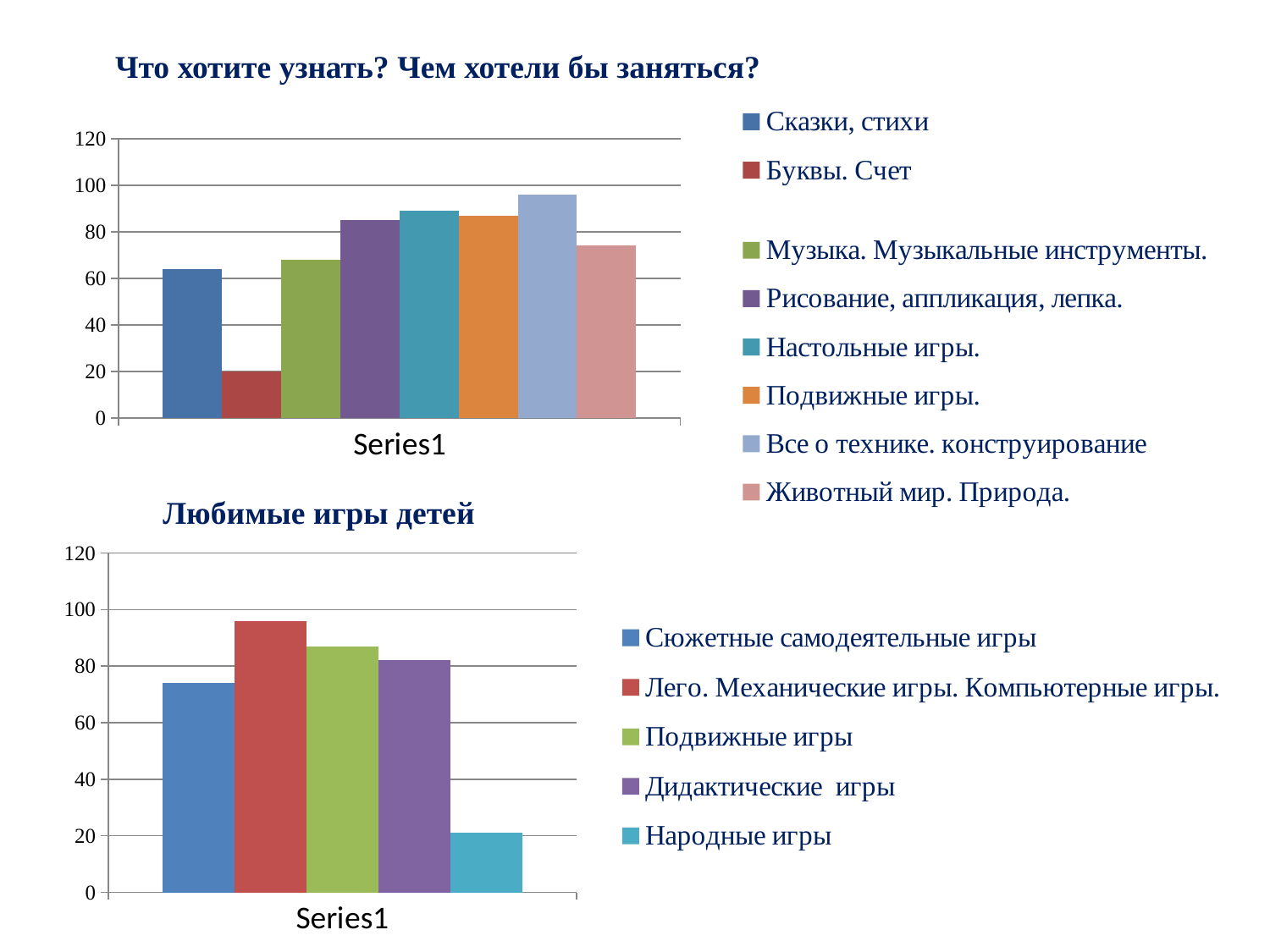
How many series does the legend of the chart titled Любимые игры детей list? 5 What kind of chart is the bottom chart on the slide? bar chart In the chart titled Любимые игры детей, is the value for Народные игры greater or less than 40? less In the chart titled Любимые игры детей, which category has the highest bar? Лего. Механические игры. Компьютерные игры. In the top chart, which is larger: the value for Рисование, аппликация, лепка. or the value for Буквы. Счет? Рисование, аппликация, лепка. In the chart titled Любимые игры детей, which is larger: the value for Сюжетные самодеятельные игры or the value for Лего. Механические игры. Компьютерные игры.? Лего. Механические игры. Компьютерные игры. In the top chart, is the value for Все о технике. конструирование greater or less than 80? greater In the top chart, which category has the highest bar? Все о технике. конструирование In the top chart, is the value for Буквы. Счет greater or less than 40? less How many series does the legend of the top chart list? 8 In the top chart, which category has the lowest bar? Буквы. Счет In the chart titled Любимые игры детей, which category has the lowest bar? Народные игры